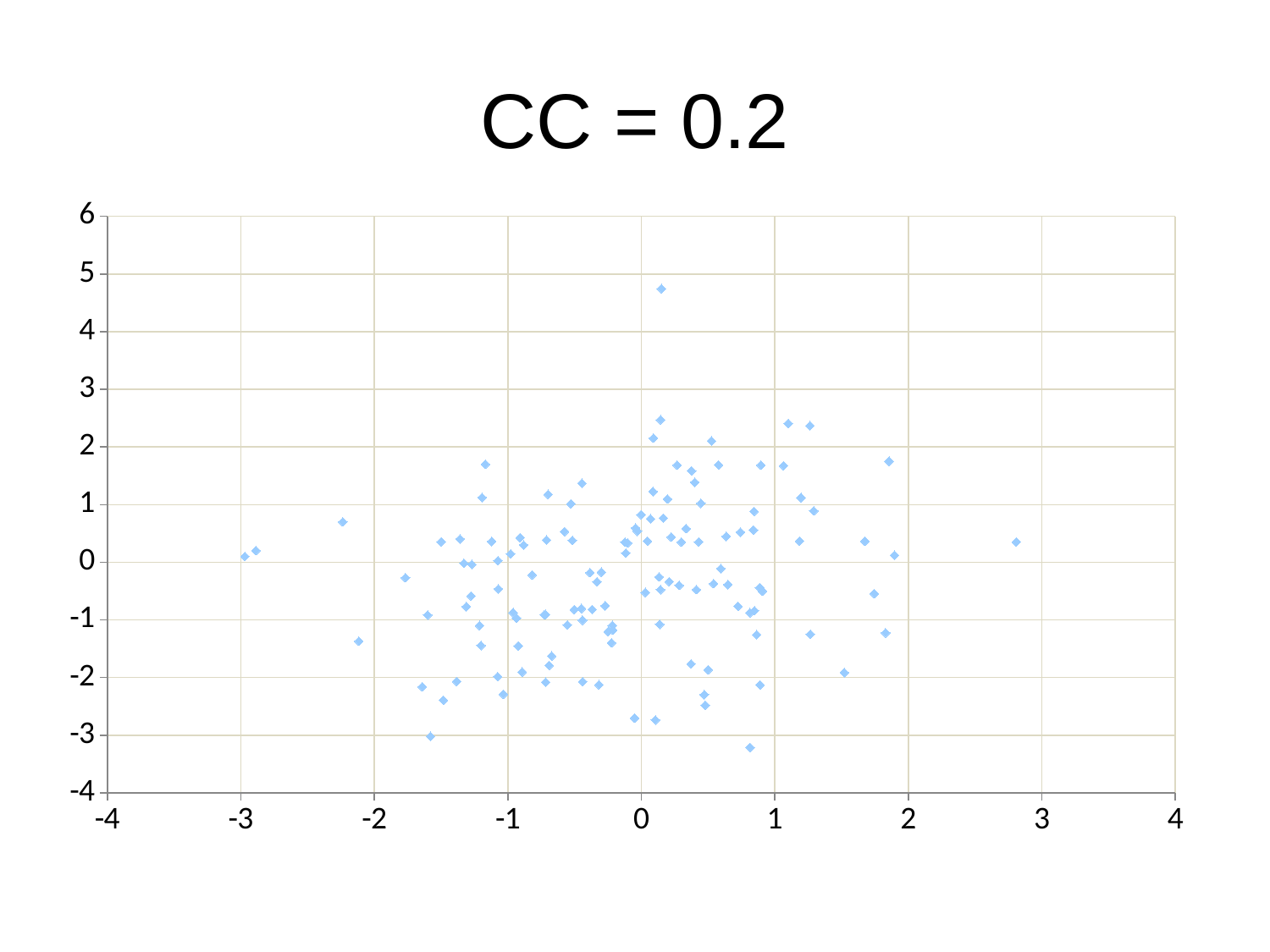
What is the maximum value shown on the y axis? 6 Is the x value of the leftmost point on the chart greater or less than -2? less Is the x value of the rightmost point on the chart greater or less than 2? greater What is the minimum value shown on the x axis? -4 What kind of chart is shown on the slide? scatter chart What is the title of the chart? CC = 0.2